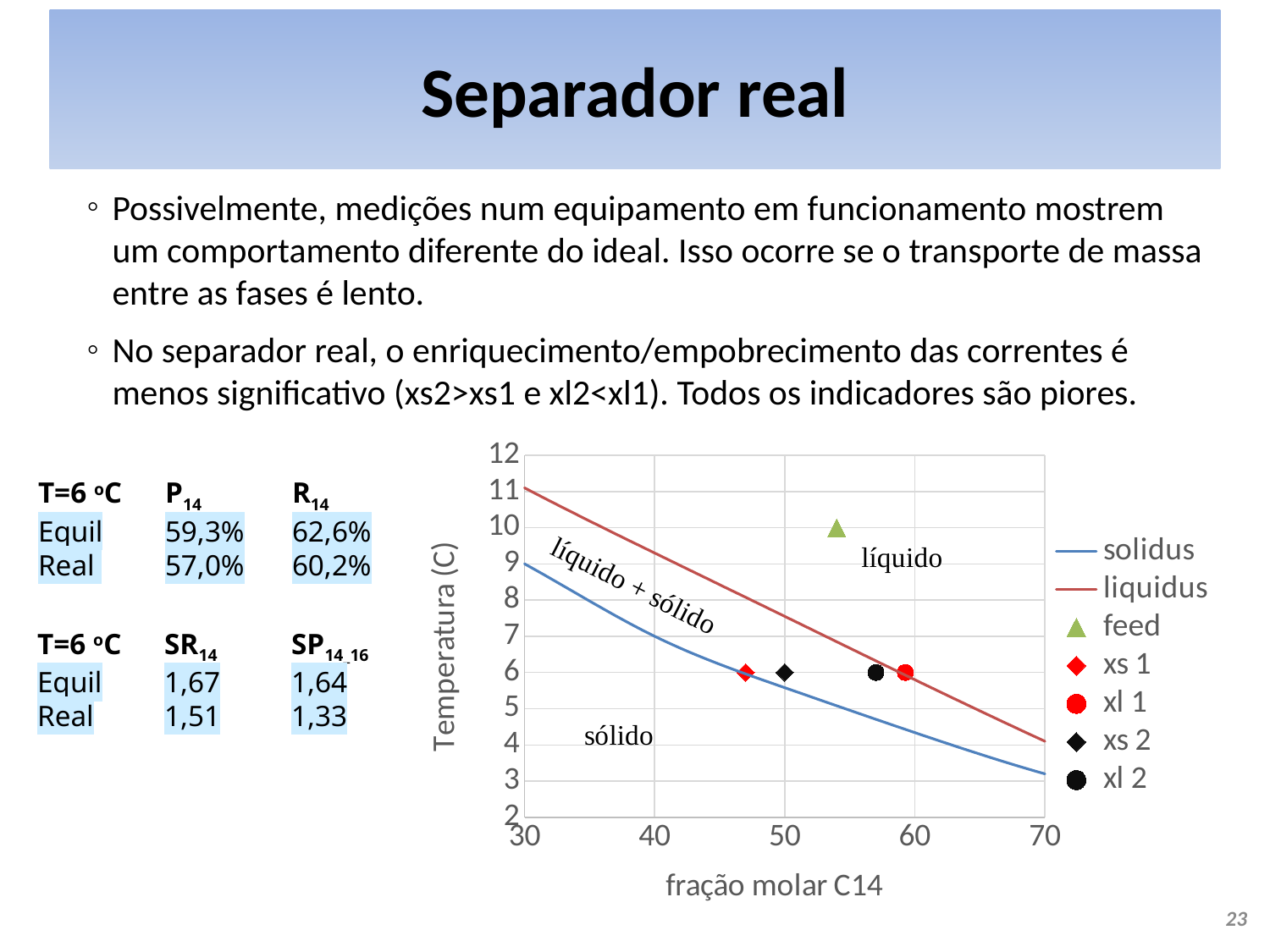
How many series does the chart legend list? 7 Which plotted point has the highest temperature? feed What kind of chart is shown on the slide? line chart with scatter points Does the liquidus line rise or fall as fração molar C14 increases? fall Is the fração molar C14 of the xs 1 point greater or less than 50? less Does the solidus line rise or fall as fração molar C14 increases? fall Is the fração molar C14 of the xl 1 point greater or less than 50? greater At a fração molar C14 of 50, which line is higher, solidus or liquidus? liquidus What is the title of the x axis of the chart? fração molar C14 Is the fração molar C14 of the feed point greater or less than 50? greater What is the title of the y axis of the chart? Temperatura (C)